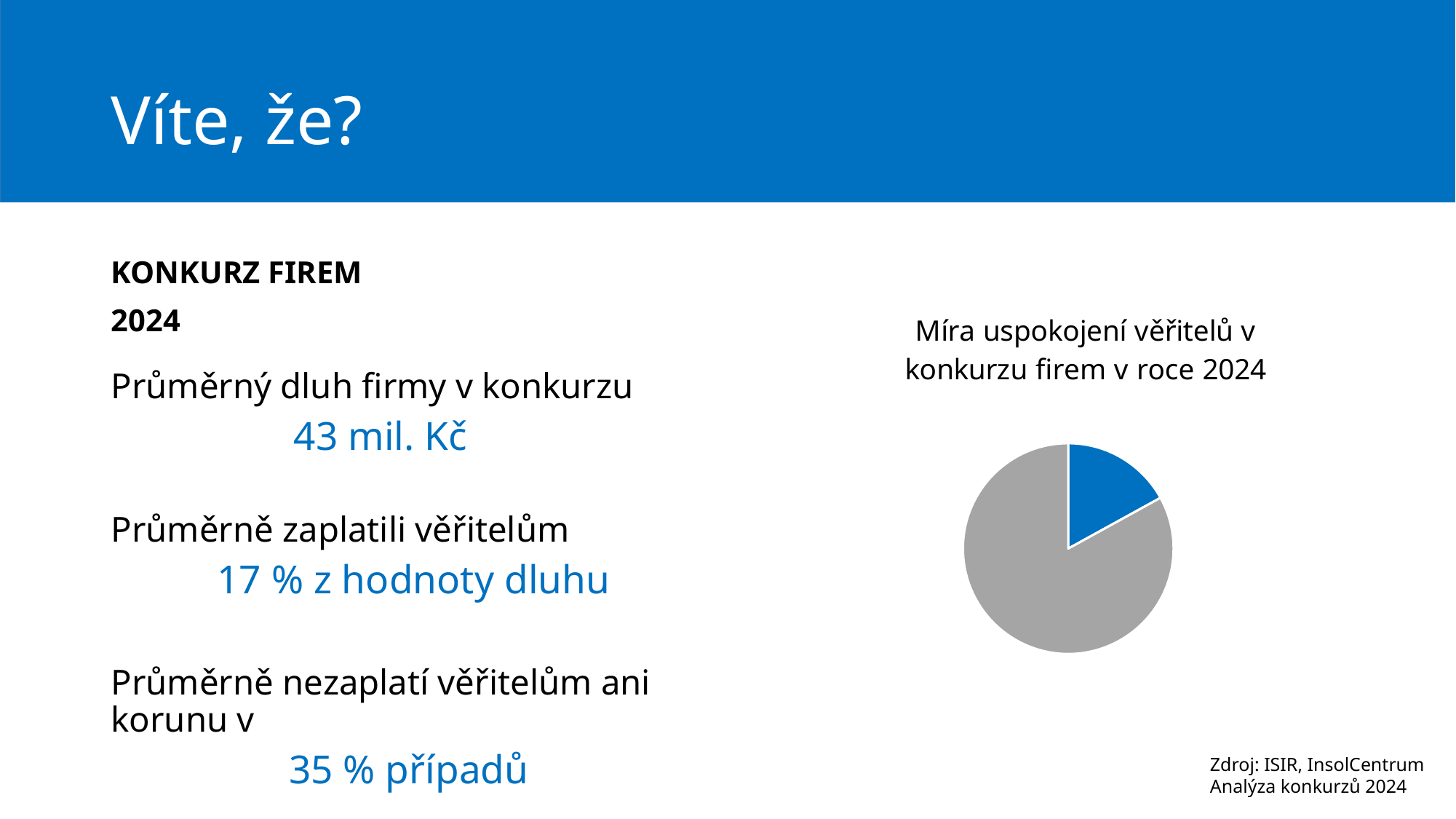
Does the blue slice of the pie chart cover more or less than half of the pie? less What kind of chart is shown on the slide? pie chart Which slice of the pie chart is the smallest? the blue slice How many slices does the pie chart have? 2 What two colours are used for the slices of the pie chart? blue and grey What is the title of the pie chart? Míra uspokojení věřitelů v konkurzu firem v roce 2024 Which slice of the pie chart is the largest? the grey slice Which slice of the pie chart is larger, the blue one or the grey one? the grey one